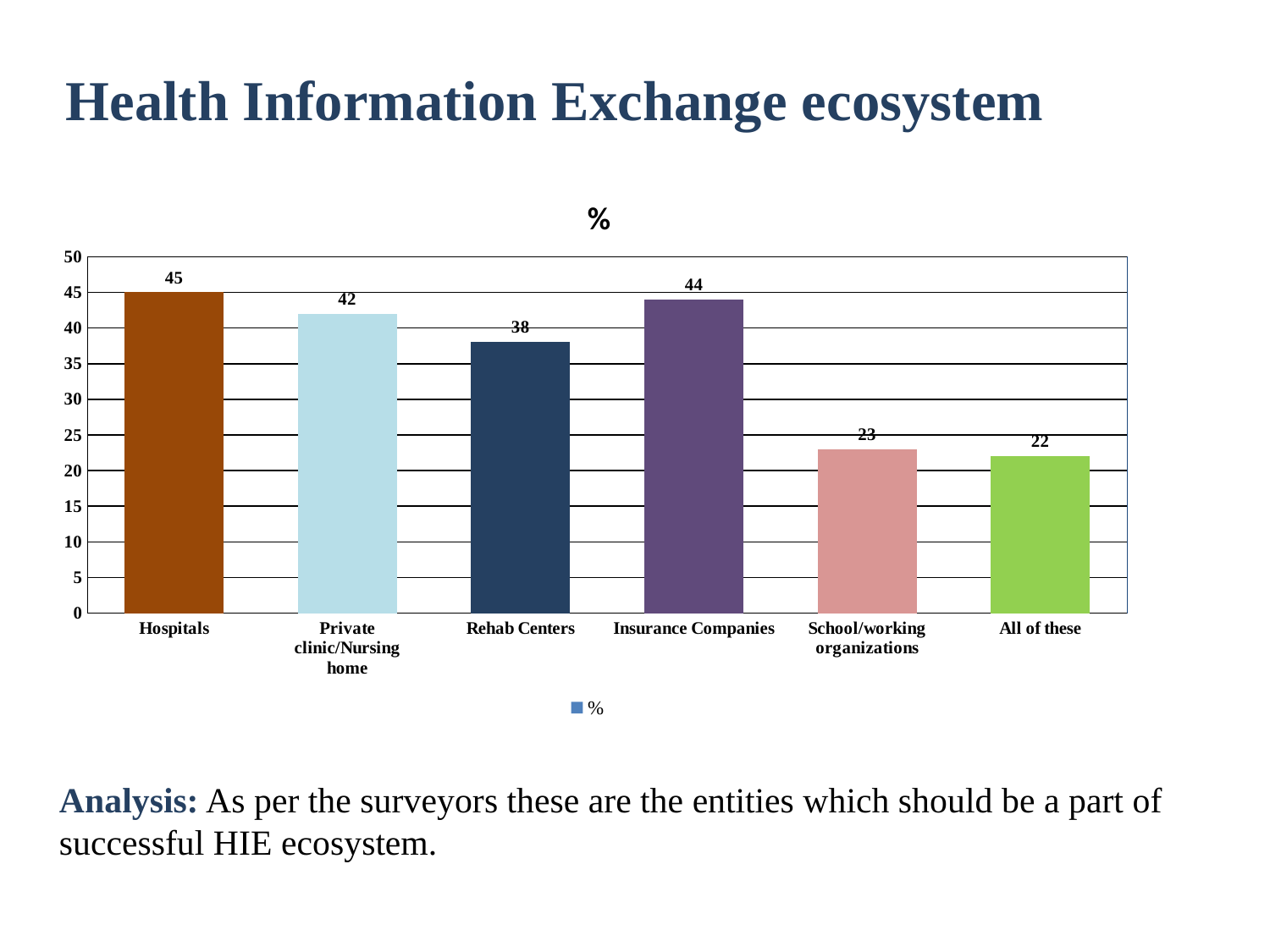
Which category has the highest value? Hospitals Is the value for Insurance Companies greater or less than 40? greater What is the difference between the values for Hospitals and Rehab Centers? 7 What is the value for School/working organizations? 23 What kind of chart is shown on the slide? bar chart How many categories are shown on the x axis? 6 What is the title of the chart? % Which is larger, the value for Private clinic/Nursing home or the value for Rehab Centers? Private clinic/Nursing home What is the value for Hospitals? 45 How many series does the legend list? 1 Which category has the lowest value? All of these What is the value for Rehab Centers? 38